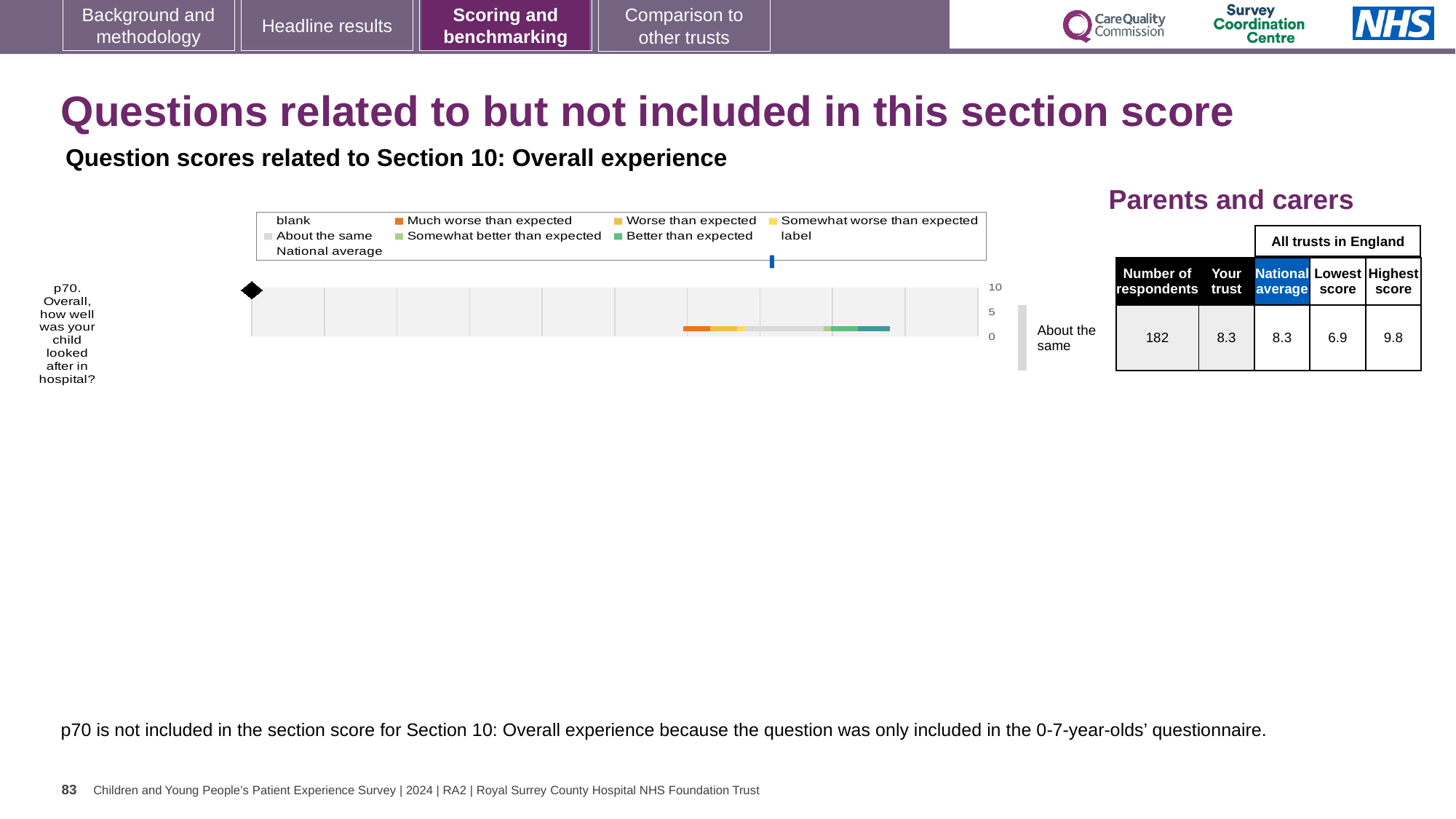
What is the national average score for p70? 8.3 How much higher is the highest score than the trust's own score for p70? 1.5 What is the lowest score among all trusts in England for p70? 6.9 What kind of chart is shown for question p70? bar chart What is the 'Your trust' score for p70 shown alongside the chart? 8.3 Is the trust's score for p70 greater or less than 5 on the chart's axis? greater How many respondents answered question p70? 182 How many questions are plotted in the chart? 1 What is the highest score among all trusts in England for p70? 9.8 What is the difference between the highest and lowest trust scores for p70? 2.9 How does the trust's score for p70 compare with the national average, according to the label next to the chart? About the same Which colour in the legend represents 'Much worse than expected'? orange